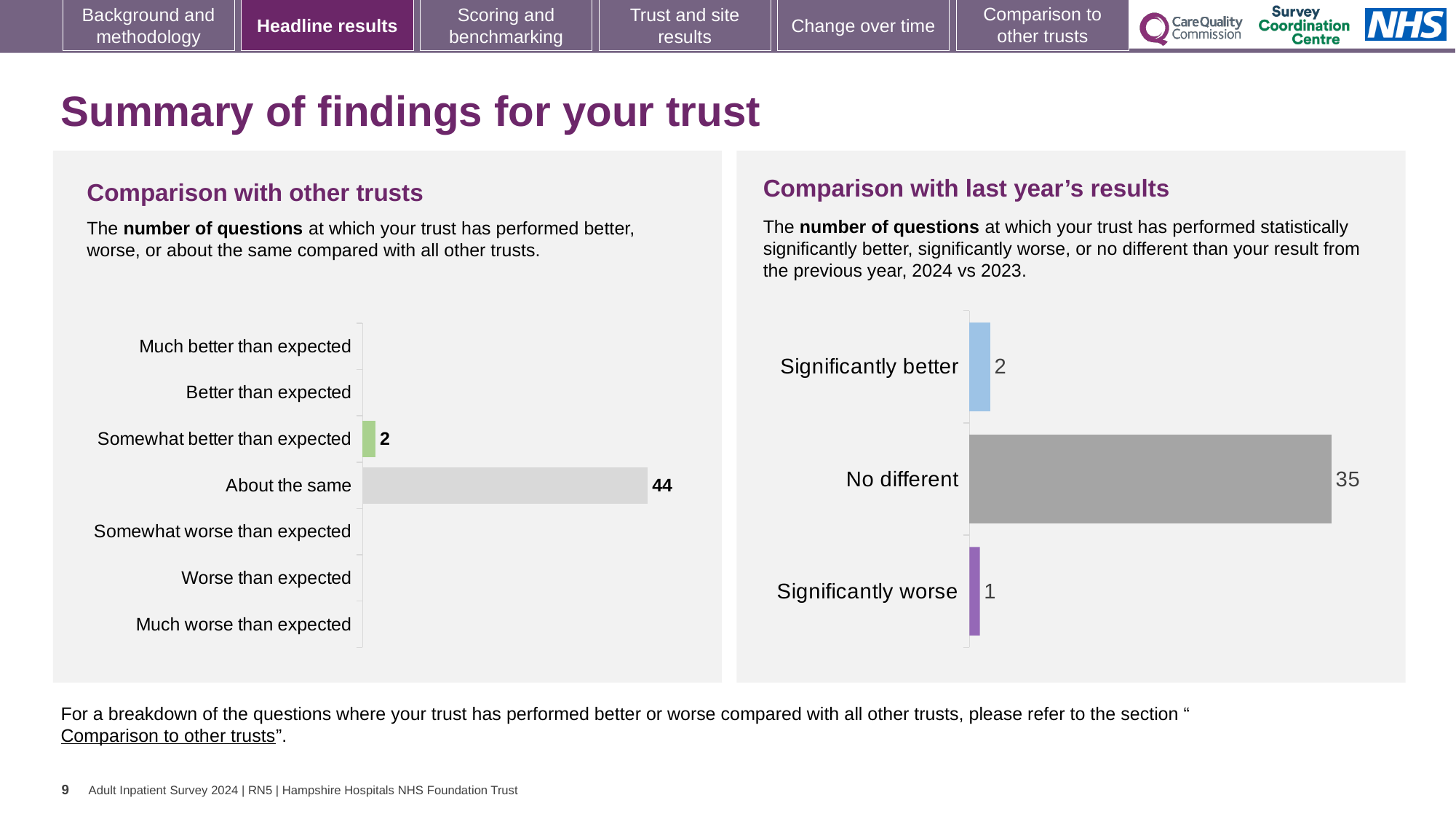
In the 'Comparison with other trusts' chart, what is the difference between 'About the same' and 'Somewhat better than expected'? 42 In the 'Comparison with last year's results' chart, how many questions are 'Significantly worse'? 1 In the 'Comparison with last year's results' chart, how many questions are 'No different'? 35 In the 'Comparison with other trusts' chart, which category has the highest number of questions? About the same In the 'Comparison with other trusts' chart, how many questions are 'About the same'? 44 In the 'Comparison with last year's results' chart, what colour is the 'No different' bar? Grey In the 'Comparison with last year's results' chart, how many questions are 'Significantly better'? 2 In the 'Comparison with last year's results' chart, is 'Significantly better' or 'Significantly worse' larger? Significantly better What type of chart is the 'Comparison with other trusts' chart? Bar chart In the 'Comparison with other trusts' chart, how many categories are listed on the axis? 7 In the 'Comparison with other trusts' chart, how many questions are 'Somewhat better than expected'? 2 In the 'Comparison with last year's results' chart, which category has the lowest number of questions? Significantly worse